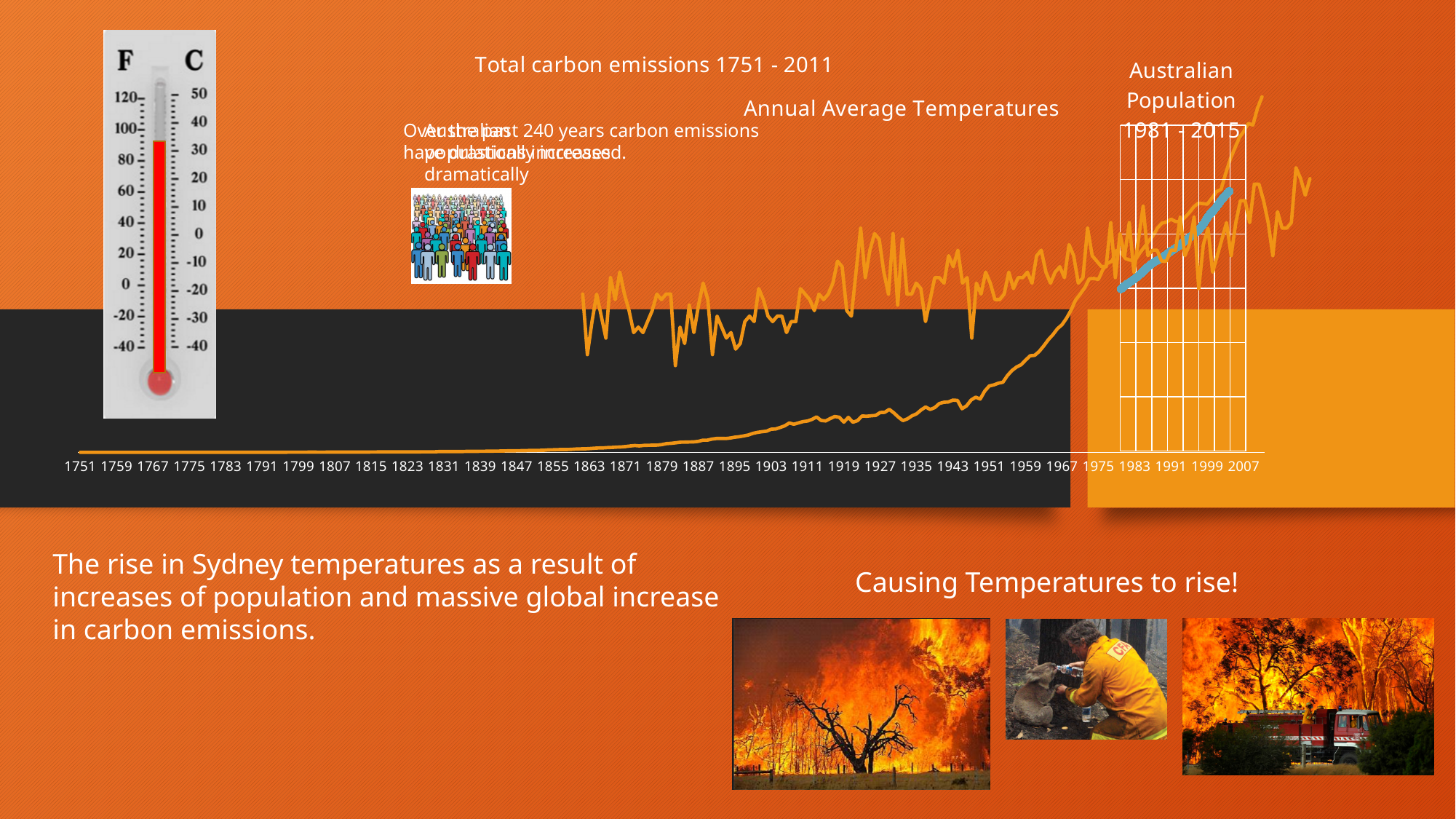
In the 'Australian Population 1981 - 2015' chart, does the line rise or fall from left to right? rise What is the title of the chart in the top right corner of the slide? Australian Population 1981 - 2015 What is the first year label on the x axis of the 'Total carbon emissions 1751 - 2011' chart? 1751 How many year labels are shown on the x axis of the 'Total carbon emissions 1751 - 2011' chart? 33 What colour is the line in the 'Australian Population 1981 - 2015' chart? blue What is the last year label on the x axis of the 'Total carbon emissions 1751 - 2011' chart? 2007 In the 'Annual Average Temperatures' chart, do the values generally rise or fall from left to right? rise In the 'Total carbon emissions 1751 - 2011' chart, do the values generally rise or fall from left to right along the x axis? rise What kind of chart is the 'Australian Population 1981 - 2015' chart? line chart What kind of chart is the 'Annual Average Temperatures' chart? line chart What kind of chart is the 'Total carbon emissions 1751 - 2011' chart? line chart